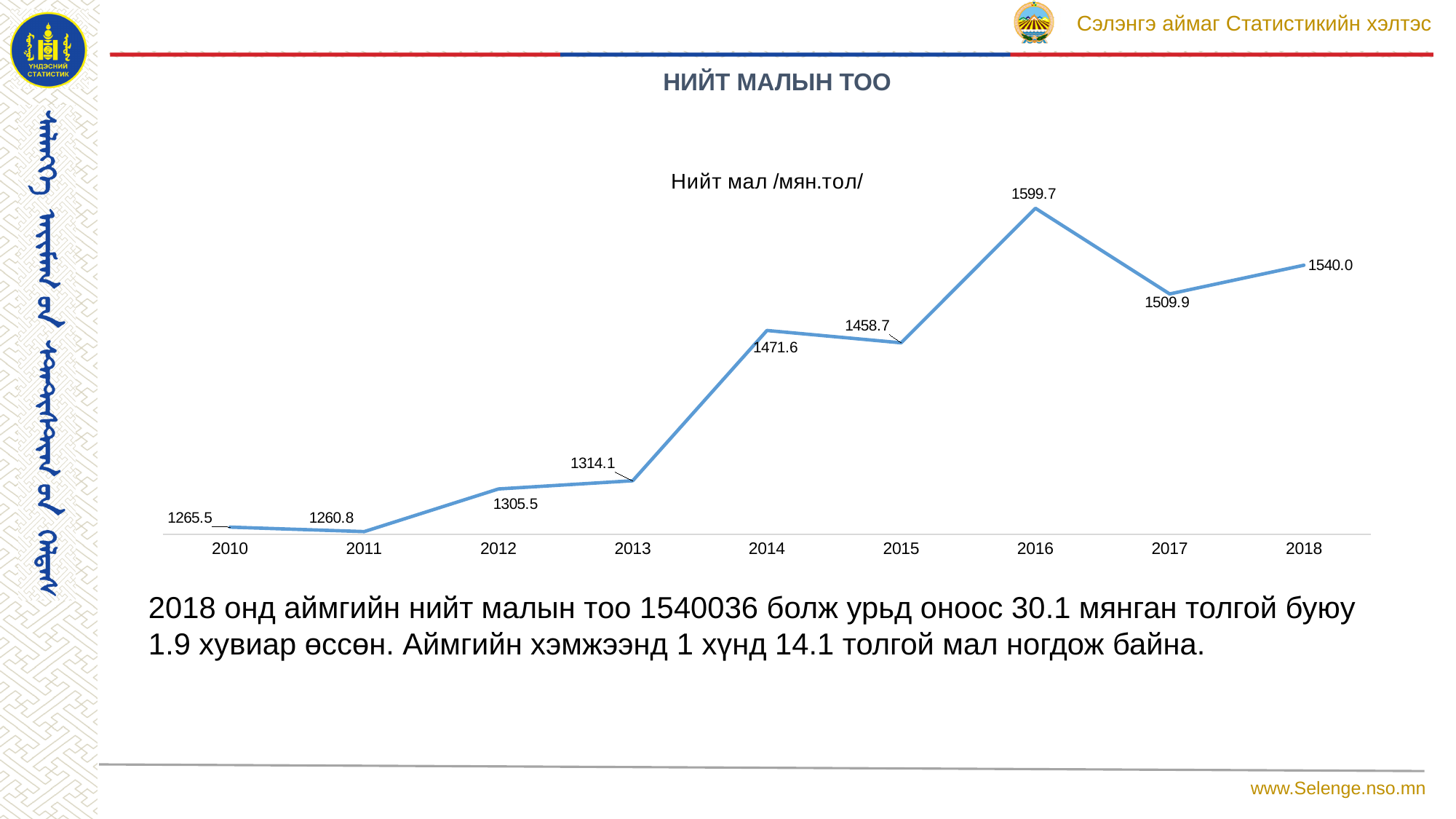
What is the value for 2018? 1540.0 What is the value for 2014? 1471.6 What is the difference between the values for 2018 and 2017? 30.1 Which year has the highest value? 2016 What is the difference between the values for 2016 and 2015? 141.0 Which is larger, the value for 2014 or the value for 2015? 2014 Which year has the lowest value? 2011 What is the title of the chart? Нийт мал /мян.тол/ What is the value for 2010? 1265.5 What kind of chart is shown on the slide? line chart How many years are plotted on the chart? 9 What is the value for 2016? 1599.7